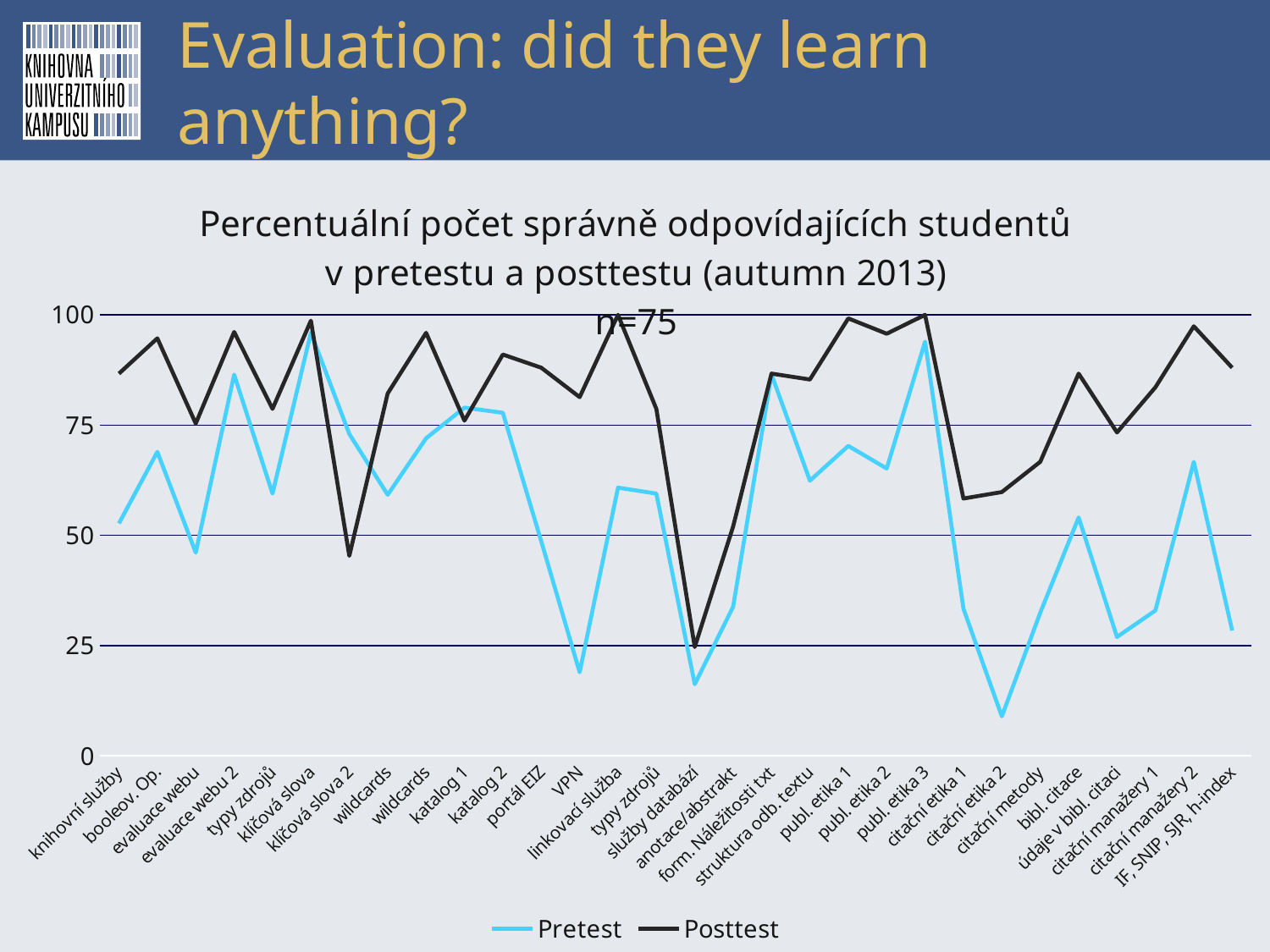
Is the Posttest value for knihovní služby greater or less than 75? greater Is the Pretest value for VPN greater or less than 25? less What kind of chart is shown on the slide? line chart Is the Pretest value for publ. etika 3 greater or less than 75? greater How many series does the legend list? 2 What sample size (n) is stated in the chart title? n=75 Which category has the lowest Pretest value? citační etika 2 For VPN, which series has the larger value, Pretest or Posttest? Posttest How many categories are plotted along the x axis? 30 Which series is drawn in light blue? Pretest